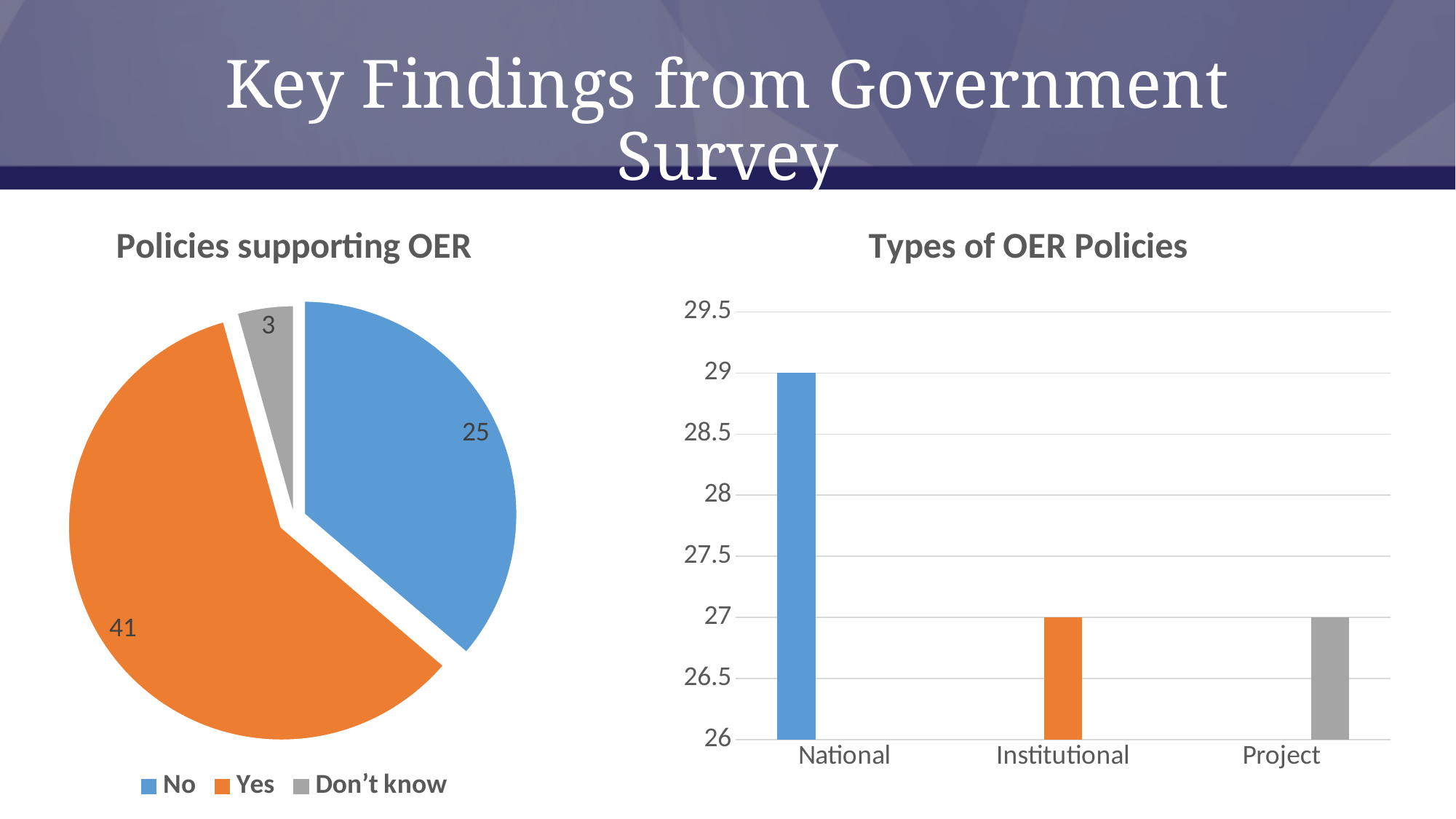
What kind of chart is 'Types of OER Policies'? Bar chart In the 'Policies supporting OER' chart, how many categories does the legend list? 3 In the 'Types of OER Policies' chart, what is the value for National? 29 In the 'Types of OER Policies' chart, which category has the highest value? National In the 'Policies supporting OER' chart, what is the value for Yes? 41 What kind of chart is 'Policies supporting OER'? Pie chart In the 'Types of OER Policies' chart, what is the difference between National and Project? 2 In the 'Policies supporting OER' chart, which category has the largest slice? Yes In the 'Policies supporting OER' chart, what is the difference between the Yes and No values? 16 In the 'Policies supporting OER' chart, which category has the smallest slice? Don't know In the 'Types of OER Policies' chart, what is the value for Institutional? 27 In the 'Policies supporting OER' chart, what is the value for No? 25